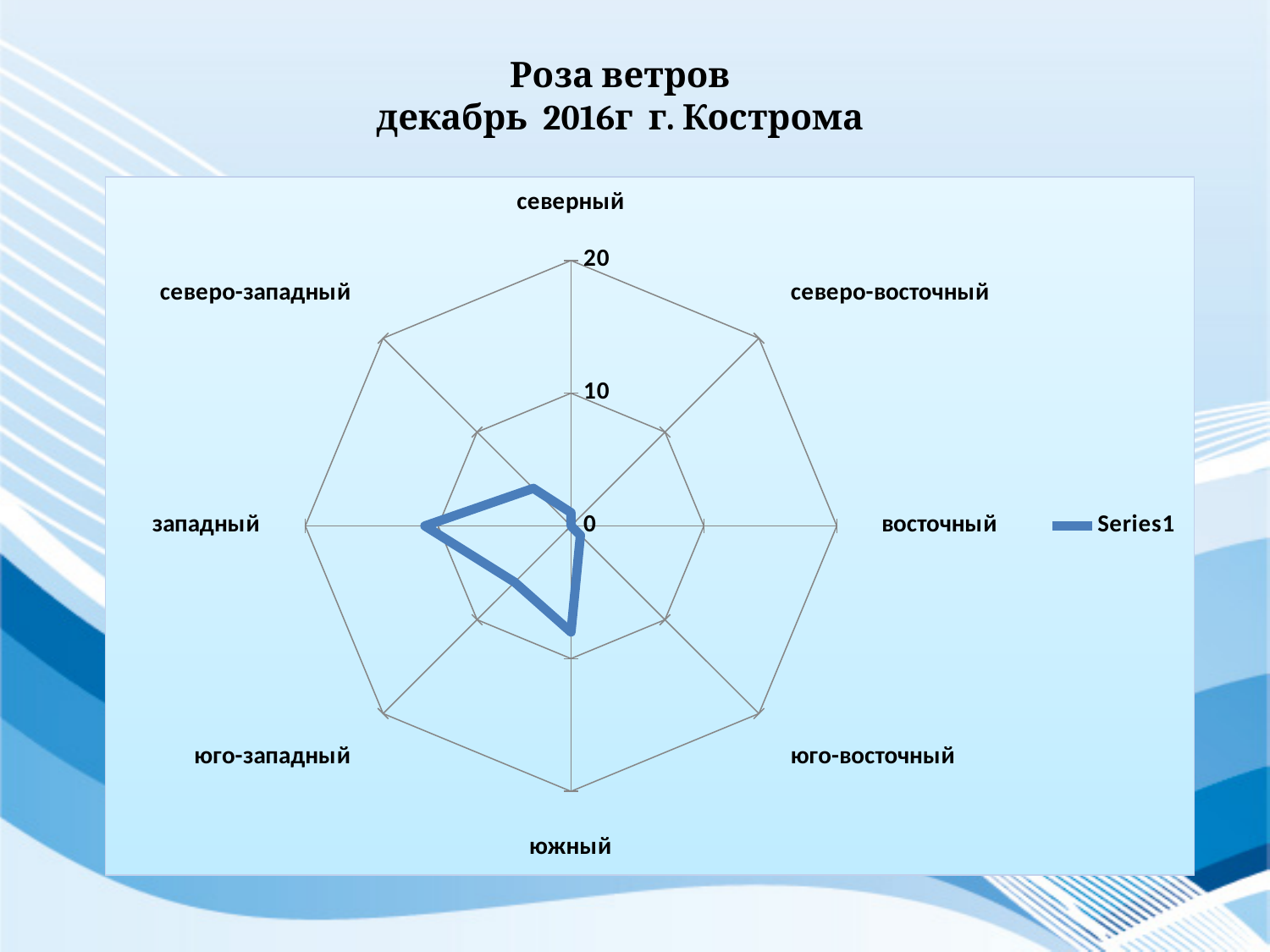
Is the value for юго-западный greater or less than 10? less Is the value for западный greater or less than 10? greater Which wind direction has the highest value on the chart? западный Is the value for южный greater or less than 10? less What is the name of the series shown in the legend? Series1 What is the maximum value shown on the chart's radial axis? 20 How many wind directions (categories) are plotted on the chart? 8 What kind of chart is shown on the slide? radar chart Which has the larger value, западный or южный? западный Which has the larger value, южный or северный? южный How many series does the legend list? 1